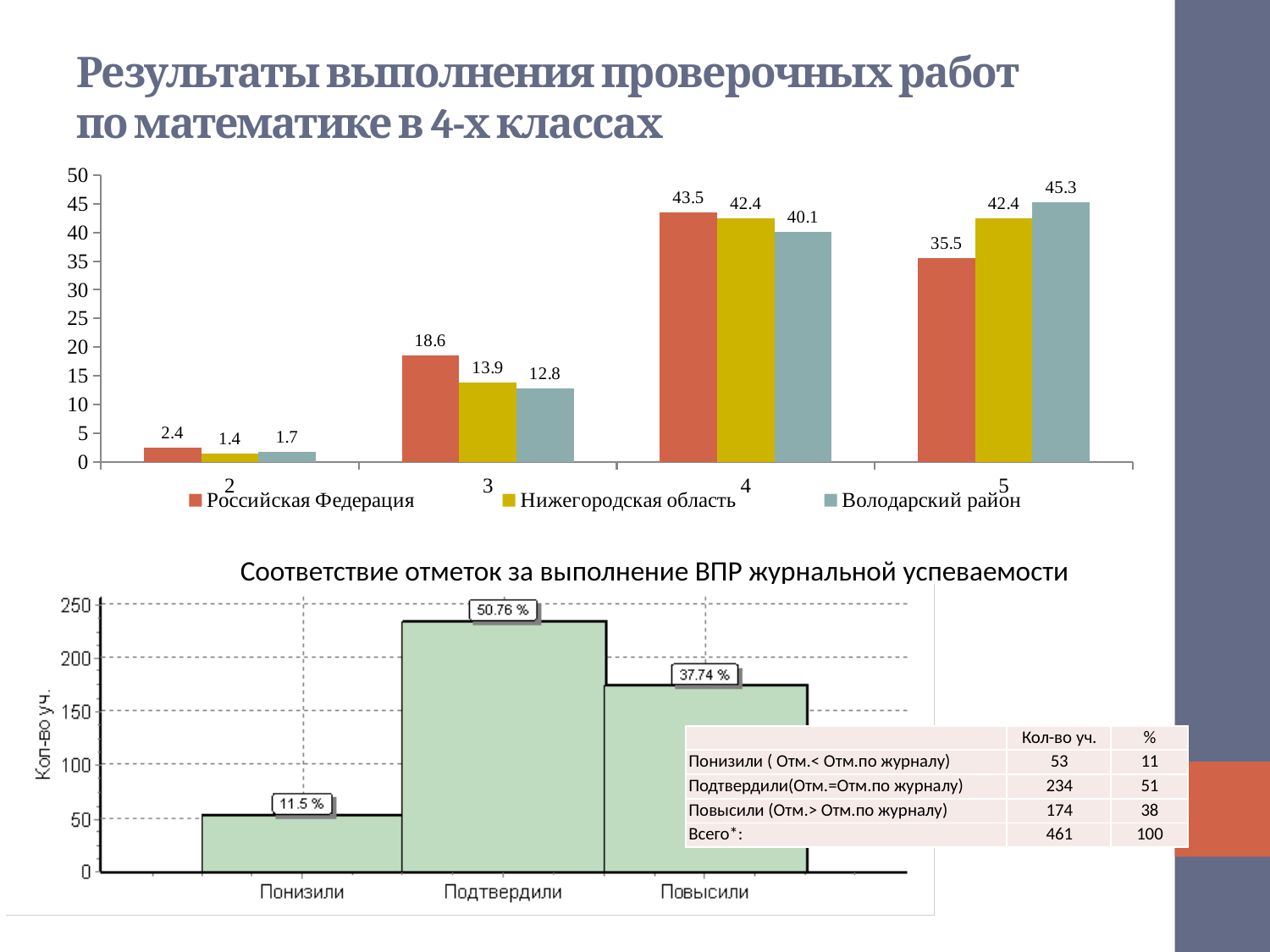
In the chart titled 'Соответствие отметок за выполнение ВПР журнальной успеваемости', what percentage is shown for Подтвердили? 50.76 % How many series does the legend of the top chart list? 3 In the top chart, what is the difference between Российская Федерация and Володарский район at category 3? 5.8 How many categories are shown on the x axis of the top chart? 4 In the top chart, which category has the lowest value for Российская Федерация? 2 In the top chart, what is the value for Нижегородская область at category 3? 13.9 In the chart titled 'Соответствие отметок за выполнение ВПР журнальной успеваемости', is the value for Повысили greater or less than 150? greater In the top chart, at category 5, which is larger: Российская Федерация or Нижегородская область? Нижегородская область What kind of chart is the bottom chart on the slide? bar chart In the top chart, what is the value for Российская Федерация at category 4? 43.5 In the top chart, what is the value for Володарский район at category 5? 45.3 In the top chart, which category has the highest value for Володарский район? 5